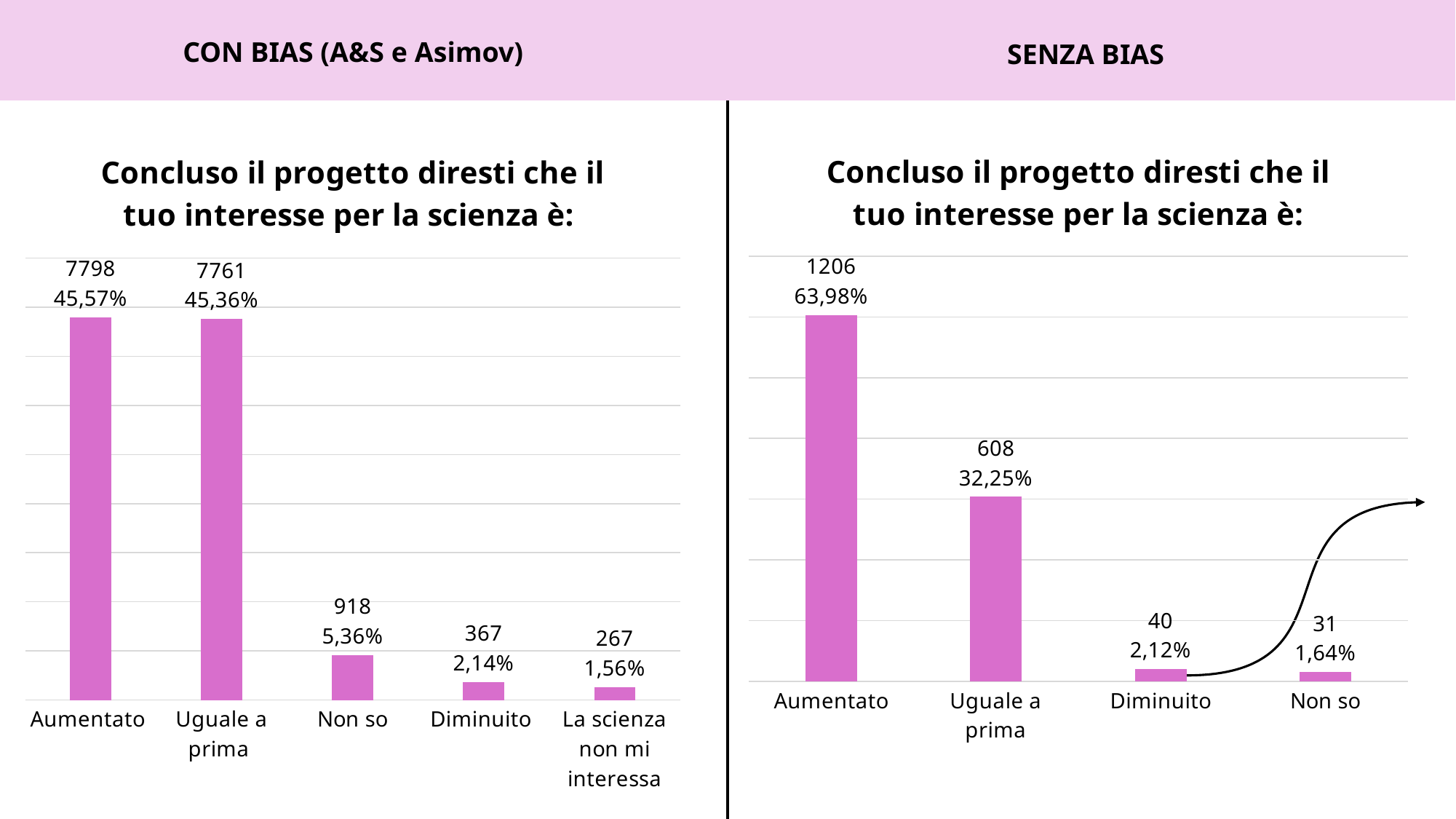
What type of chart is the right chart (SENZA BIAS)? Bar chart How many categories are shown in the right chart (SENZA BIAS)? 4 How many categories are shown in the left chart (CON BIAS)? 5 In the left chart (CON BIAS), what is the difference between the counts for Aumentato and Uguale a prima? 37 In the left chart (CON BIAS), what is the count for Aumentato? 7798 In the right chart (SENZA BIAS), what is the count for Uguale a prima? 608 In the left chart (CON BIAS), what percentage is shown for Non so? 5,36% In the right chart (SENZA BIAS), which category has the highest value? Aumentato In the left chart (CON BIAS), which category has the lowest value? La scienza non mi interessa In the right chart (SENZA BIAS), what is the difference between the counts for Diminuito and Non so? 9 In the right chart (SENZA BIAS), what percentage is shown for Aumentato? 63,98% In the right chart (SENZA BIAS), which is larger, the value for Aumentato or Uguale a prima? Aumentato